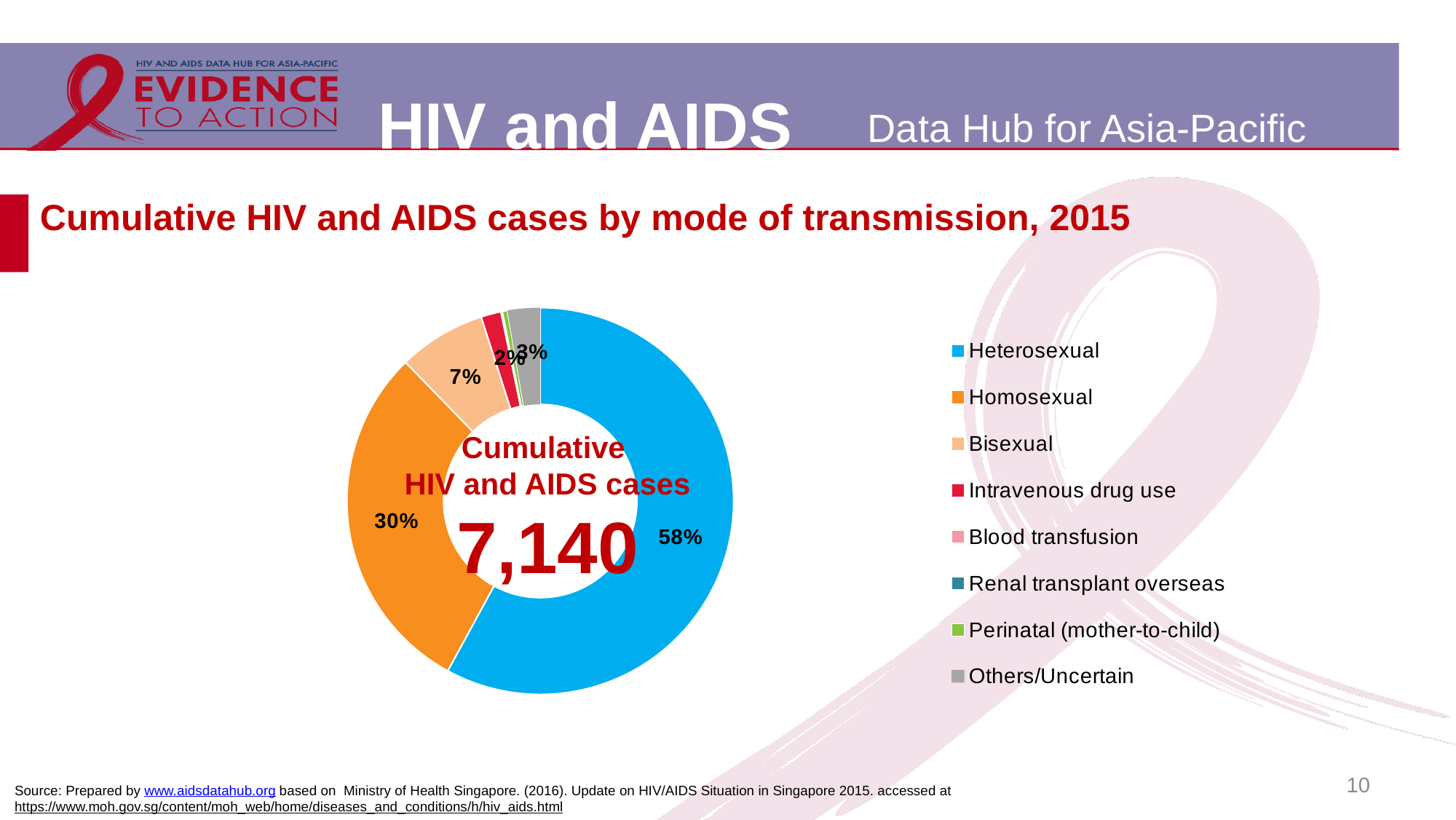
What percentage of cumulative cases falls under Others/Uncertain? 3% What percentage of cumulative cases is attributed to homosexual transmission? 30% What share of cumulative HIV and AIDS cases is attributed to heterosexual transmission? 58% What percentage of cumulative cases is attributed to bisexual transmission? 7% Which accounts for a larger share of cases, homosexual or bisexual transmission? Homosexual What percentage of cumulative cases is attributed to intravenous drug use? 2% What colour represents heterosexual transmission in the chart? Blue Which mode of transmission accounts for the largest share of cumulative HIV and AIDS cases? Heterosexual What is the total number of cumulative HIV and AIDS cases shown in the centre of the chart? 7,140 How many modes of transmission are listed in the legend? 8 By how many percentage points does the heterosexual share exceed the homosexual share? 28 percentage points What type of chart is used on this slide? Pie (donut) chart